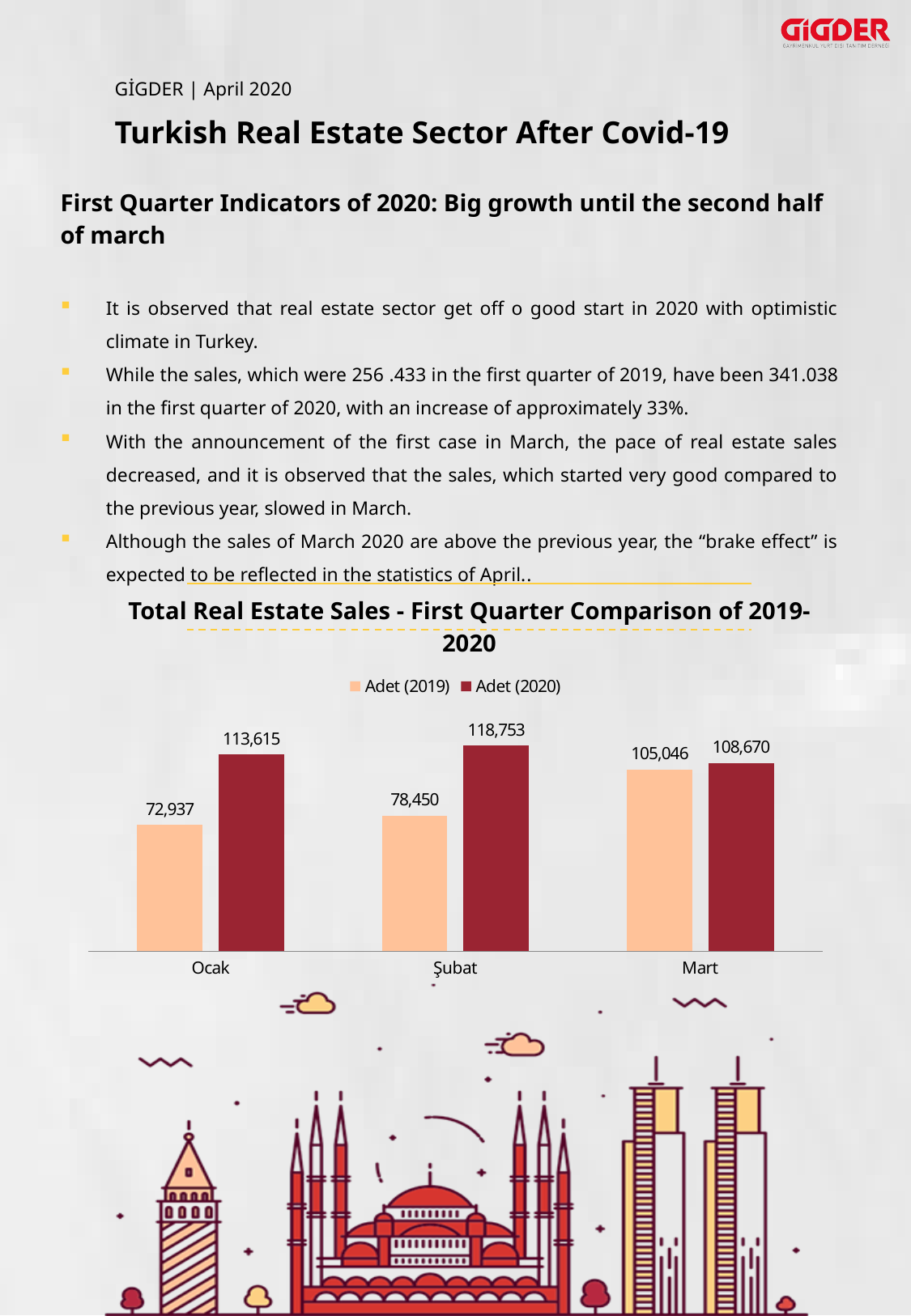
What type of chart is shown on the slide? Bar chart What is the value of Adet (2019) for Mart? 105,046 What is the difference between Adet (2020) and Adet (2019) for Ocak? 40,678 What is the value of Adet (2020) for Mart? 108,670 How many series does the chart legend list? 2 What is the value of Adet (2019) for Ocak? 72,937 Which month has the highest Adet (2020) value? Şubat What is the value of Adet (2020) for Şubat? 118,753 What is the difference between Adet (2020) and Adet (2019) for Mart? 3,624 How many months are shown on the x axis of the chart? 3 Which month has the lowest Adet (2019) value? Ocak Which is larger for Şubat, Adet (2019) or Adet (2020)? Adet (2020)